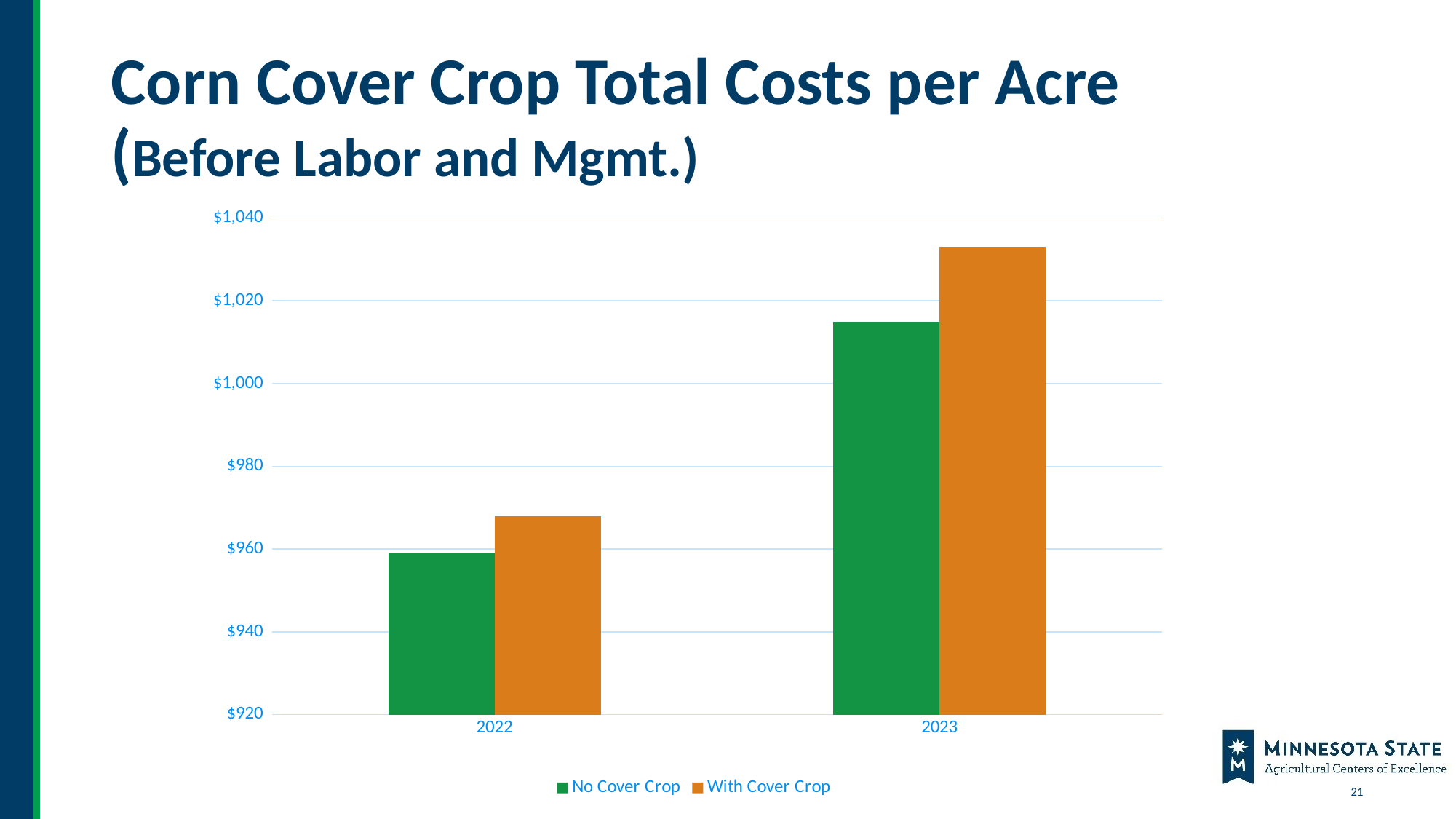
Which bar is the highest on the chart? With Cover Crop in 2023 What kind of chart is shown on the slide? bar chart What is the title of the slide's chart? Corn Cover Crop Total Costs per Acre (Before Labor and Mgmt.) Which bar is the lowest on the chart? No Cover Crop in 2022 How many year categories are shown on the x axis? 2 Which series is shown in orange? With Cover Crop Is the value for With Cover Crop in 2022 greater or less than $960? greater In 2023, which is larger: No Cover Crop or With Cover Crop? With Cover Crop Is the value for With Cover Crop in 2023 greater or less than $1,020? greater Is the value for No Cover Crop in 2023 greater or less than $1,000? greater How many series does the legend list? 2